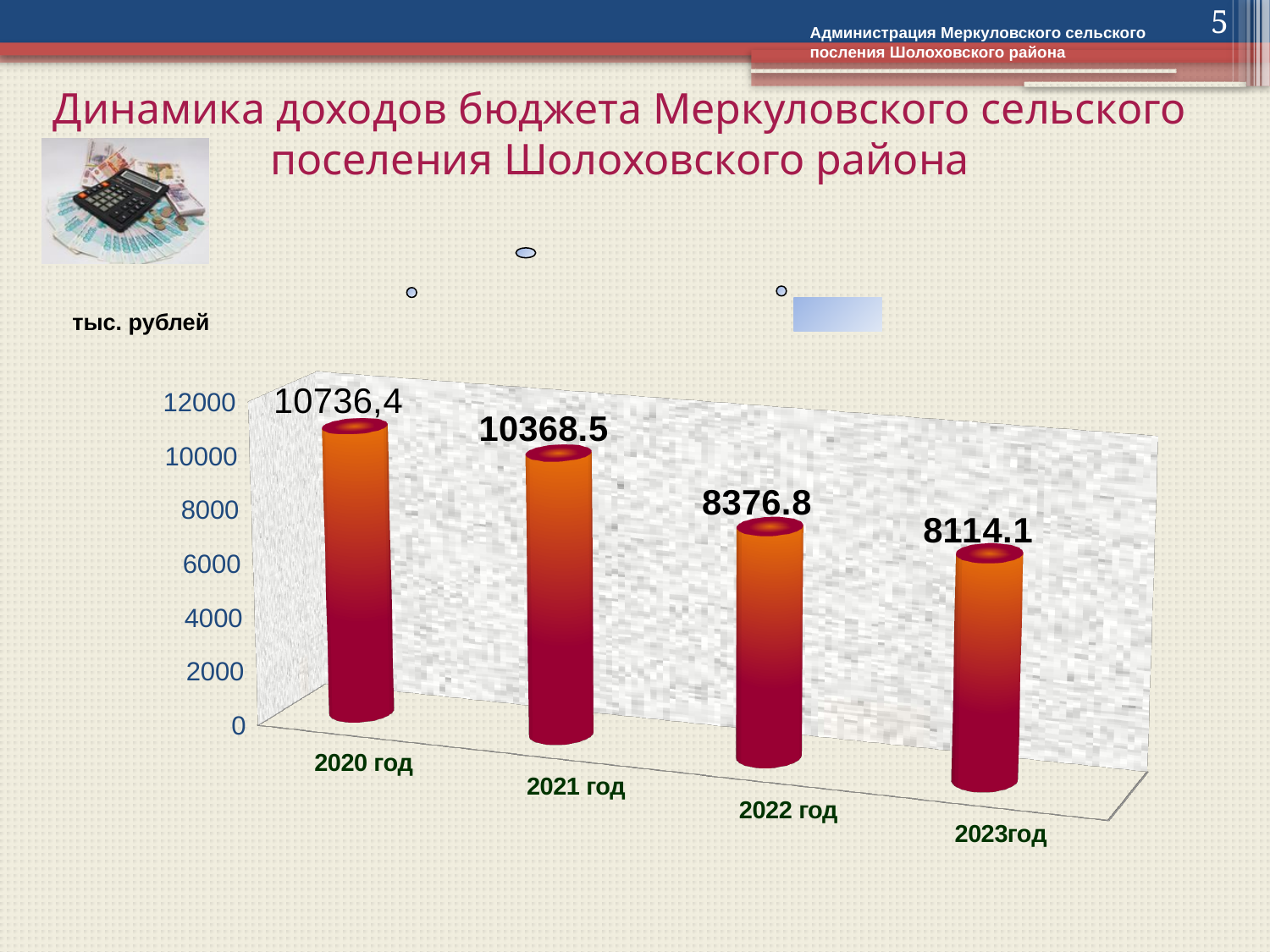
What is the value for 2022 год? 8376.8 How many years are shown in the chart? 4 Do the values rise or fall from 2020 год to 2023год? Fall Which year has the highest value? 2020 год What is the value for 2020 год? 10736,4 What is the value for 2021 год? 10368.5 What is the difference between the values for 2022 год and 2023год? 262.7 What is the difference between the values for 2021 год and 2022 год? 1991.7 Which year has the lowest value? 2023год Which is larger, the value for 2020 год or the value for 2021 год? 2020 год What is the value for 2023год? 8114.1 What kind of chart is shown on the slide? Bar chart